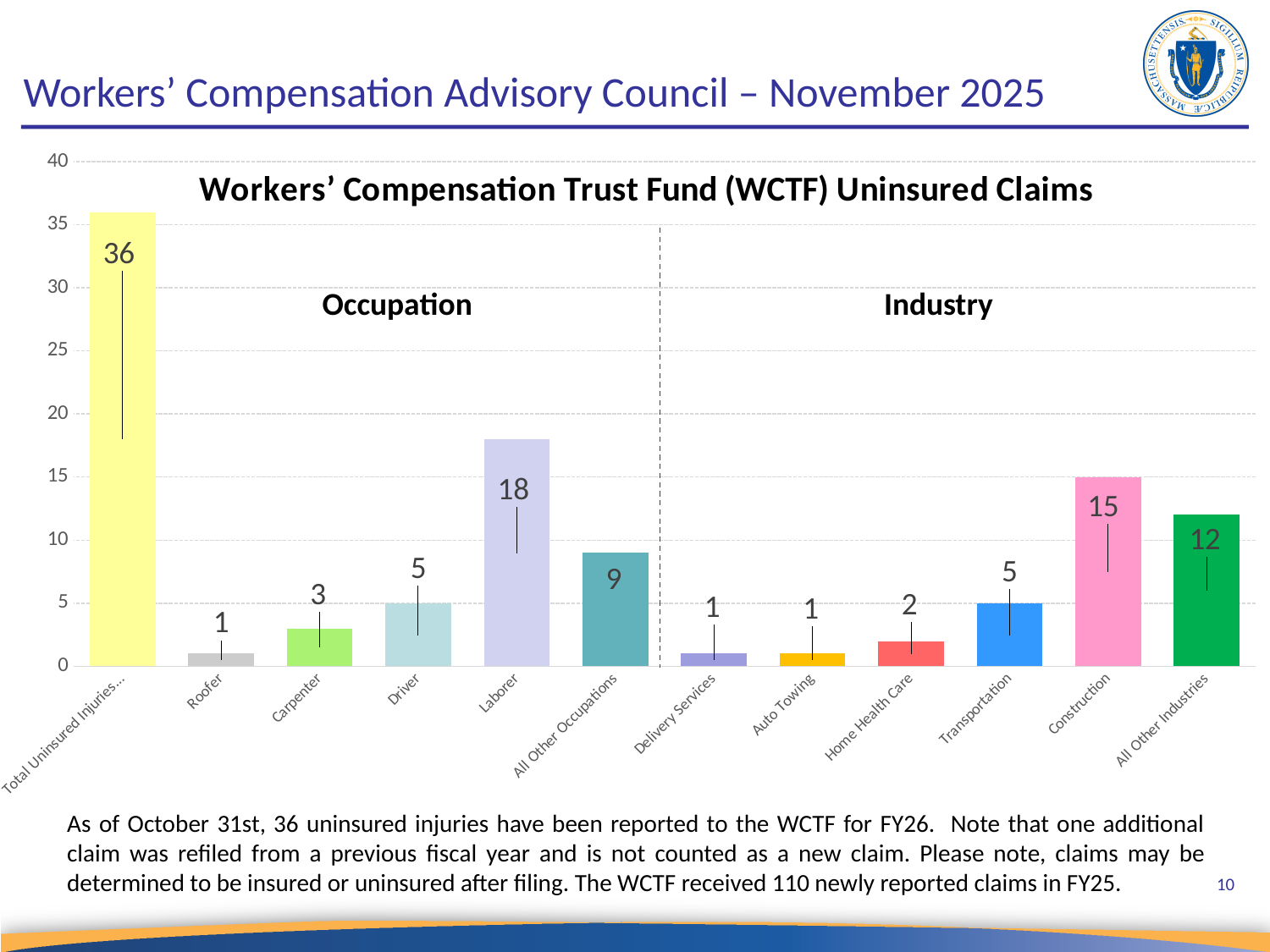
Which is larger, the value for Laborer or the value for All Other Industries? Laborer What is the value for Construction? 15 What is the value for Home Health Care? 2 What is the value for Laborer? 18 What is the difference between the values for Laborer and Construction? 3 Among the Industry categories, which has the highest value? Construction Which category has the highest value? Total Uninsured Injuries What is the value for All Other Industries? 12 What kind of chart is this? Bar chart How many categories are shown on the x axis? 12 What is the title of the chart? Workers' Compensation Trust Fund (WCTF) Uninsured Claims What is the difference between the values for All Other Occupations and Driver? 4